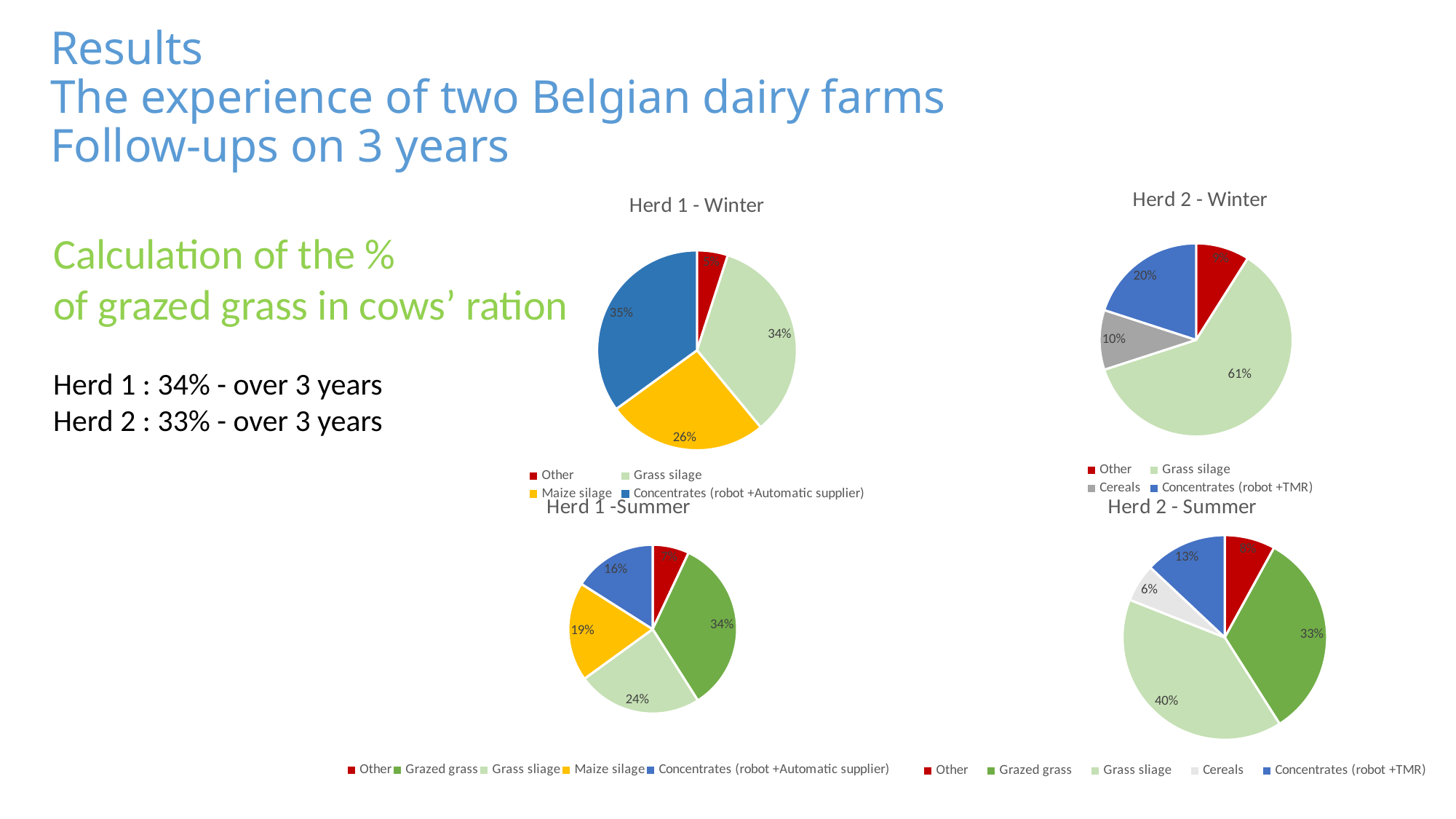
In the Herd 1 - Winter chart, what percentage is Maize silage? 26% In the Herd 2 - Winter chart, what is the difference between the Grass silage share and the Concentrates (robot +TMR) share? 41 percentage points In the Herd 2 - Summer chart, what percentage is Concentrates (robot +TMR)? 13% In the Herd 2 - Summer chart, which category has the largest share? Grass silage How many categories does the legend of the Herd 2 - Summer chart list? 5 In the Herd 2 - Winter chart, what percentage is Grass silage? 61% In the Herd 1 - Summer chart, what percentage is Grazed grass? 34% How many categories does the legend of the Herd 1 - Winter chart list? 4 In the Herd 1 - Winter chart, which category has the largest share? Concentrates (robot +Automatic supplier) In the Herd 2 - Summer chart, what colour is the Grazed grass slice? Green What type of chart is the Herd 2 - Winter chart? Pie chart In the Herd 1 - Summer chart, which is larger: Grass silage or Maize silage? Grass silage